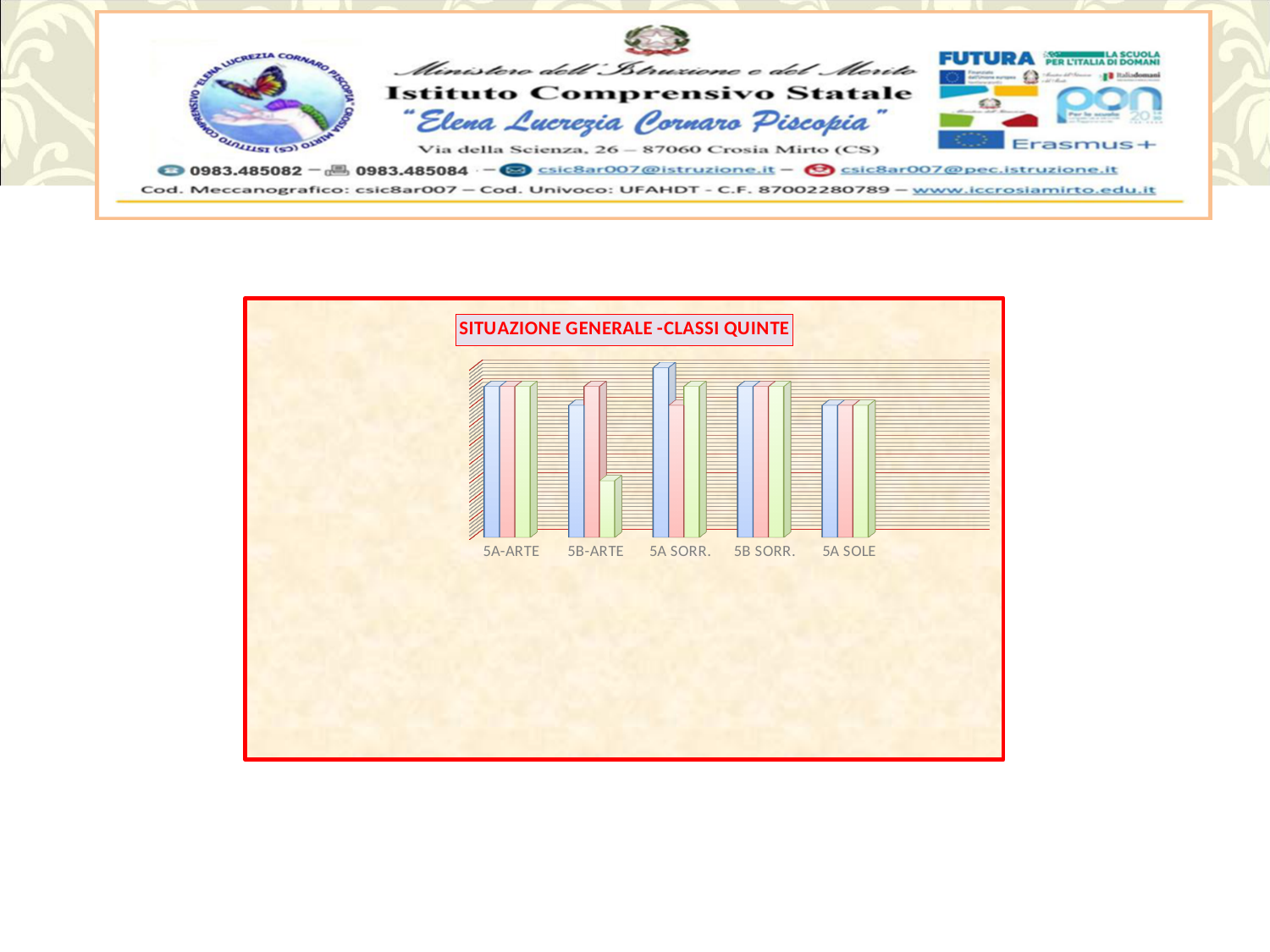
Which is taller in the 5B-ARTE category, the blue bar or the pink bar? pink Which is taller, the green bar for 5B-ARTE or the green bar for 5B SORR.? 5B SORR. Which category contains the tallest bar in the chart? 5A SORR. What kind of chart is shown on the slide? bar chart What is the title of the chart? SITUAZIONE GENERALE -CLASSI QUINTE In the 5B-ARTE category, which coloured bar is the shortest? green Which category is listed first on the x axis of the chart? 5A-ARTE How many bars are plotted for each category in the chart? 3 Which is taller, the blue bar for 5A SORR. or the blue bar for 5A SOLE? 5A SORR. In the 5A SORR. category, which coloured bar is the tallest? blue How many categories are shown on the x axis of the chart? 5 Which category contains the shortest bar in the chart? 5B-ARTE